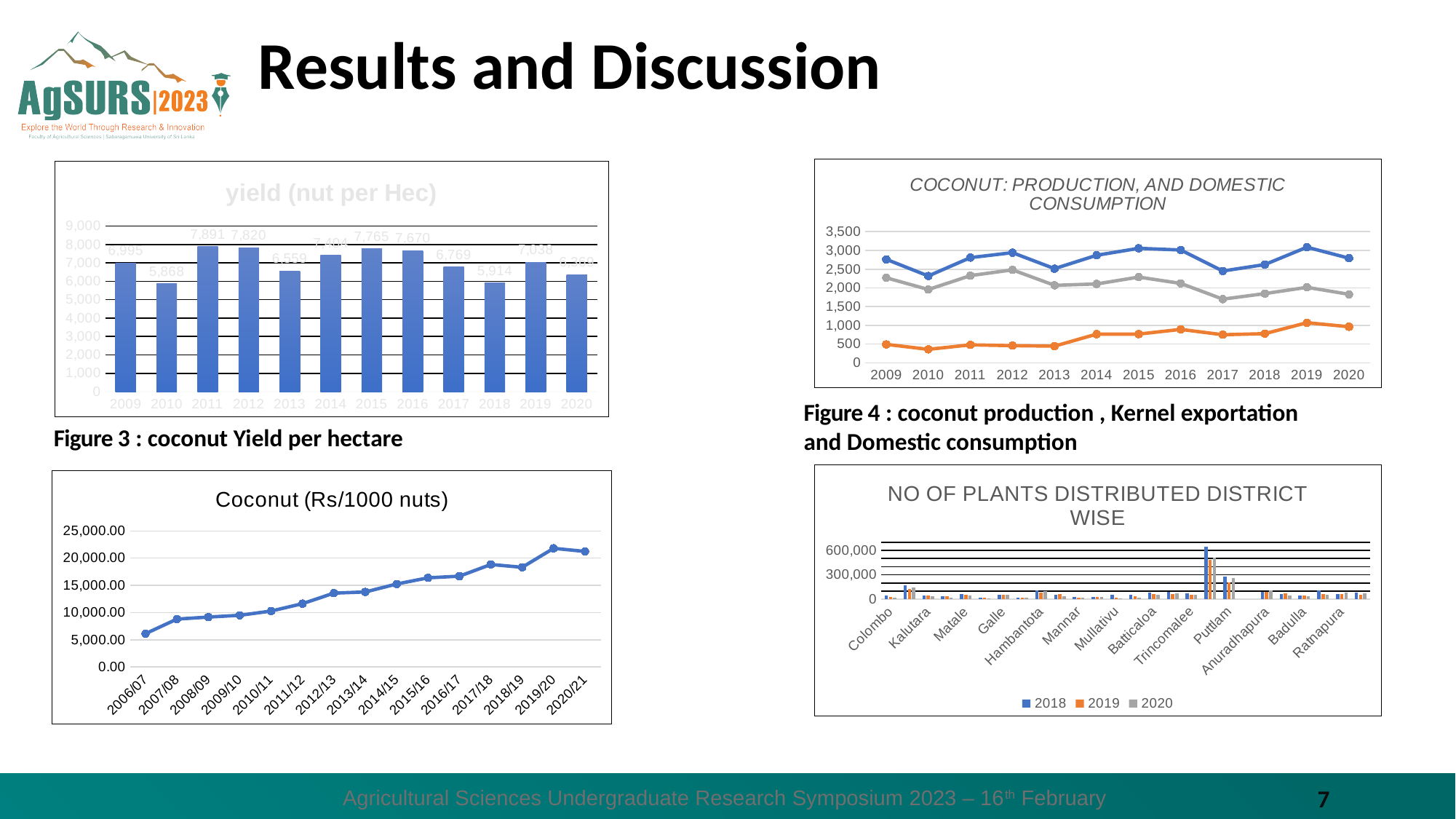
In the 'NO OF PLANTS DISTRIBUTED DISTRICT WISE' chart, how many series does the legend list? 3 In the 'COCONUT: PRODUCTION, AND DOMESTIC CONSUMPTION' chart, how many years are shown on the x axis? 12 In the 'yield (nut per Hec)' chart, what is the yield for 2011? 7,891 In the 'yield (nut per Hec)' chart, which year has the lowest yield? 2010 In the 'yield (nut per Hec)' chart, how many years are plotted? 12 In the 'yield (nut per Hec)' chart, what is the yield for 2010? 5,868 In the 'yield (nut per Hec)' chart, what is the difference between the 2011 and 2010 yields? 2,023 In the 'Coconut (Rs/1000 nuts)' chart, is the value for 2006/07 greater or less than 10,000.00? less In the 'yield (nut per Hec)' chart, which year has the highest yield? 2011 In the 'Coconut (Rs/1000 nuts)' chart, do values generally rise or fall from 2006/07 to 2020/21? rise What kind of chart is the 'Coconut (Rs/1000 nuts)' chart? line chart